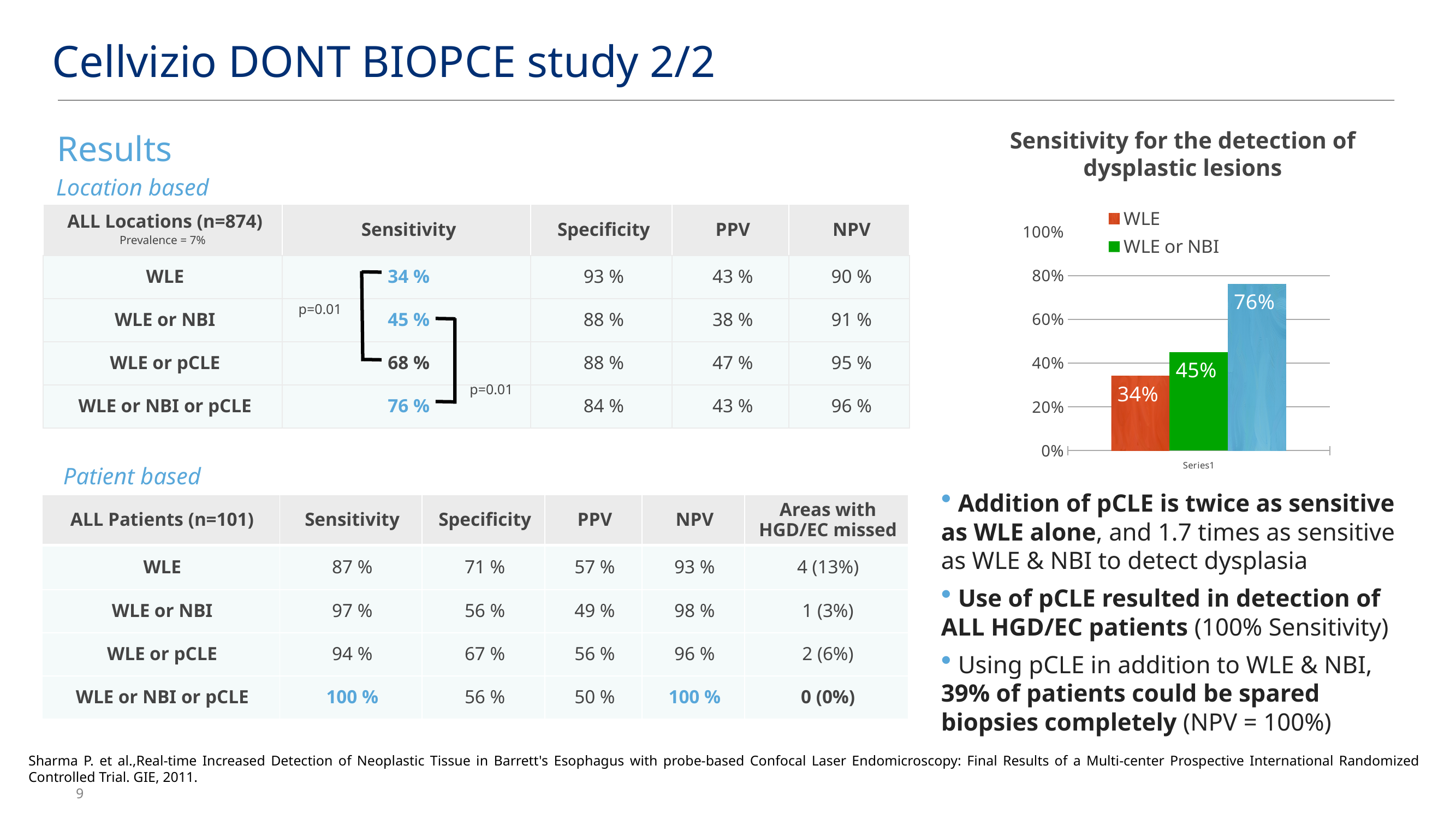
In the chart 'Sensitivity for the detection of dysplastic lesions', which is larger, the WLE bar or the WLE or NBI bar? WLE or NBI How many bars are plotted in the chart 'Sensitivity for the detection of dysplastic lesions'? 3 In the chart 'Sensitivity for the detection of dysplastic lesions', what is the difference between the blue bar (76%) and the WLE bar? 42 percentage points In the chart 'Sensitivity for the detection of dysplastic lesions', which legend entry has the lowest bar? WLE How many entries does the legend of the chart 'Sensitivity for the detection of dysplastic lesions' list? 2 In the chart 'Sensitivity for the detection of dysplastic lesions', what is the value shown for WLE or NBI? 45% In the chart 'Sensitivity for the detection of dysplastic lesions', how much higher is the WLE or NBI bar than the WLE bar? 11 percentage points In the chart 'Sensitivity for the detection of dysplastic lesions', what is the value shown for WLE? 34% In the chart 'Sensitivity for the detection of dysplastic lesions', is the value for WLE greater or less than 40%? less In the chart 'Sensitivity for the detection of dysplastic lesions', what value is labelled on the blue bar? 76% What kind of chart is 'Sensitivity for the detection of dysplastic lesions'? Bar chart In the chart 'Sensitivity for the detection of dysplastic lesions', what is the highest value labelled on any bar? 76%